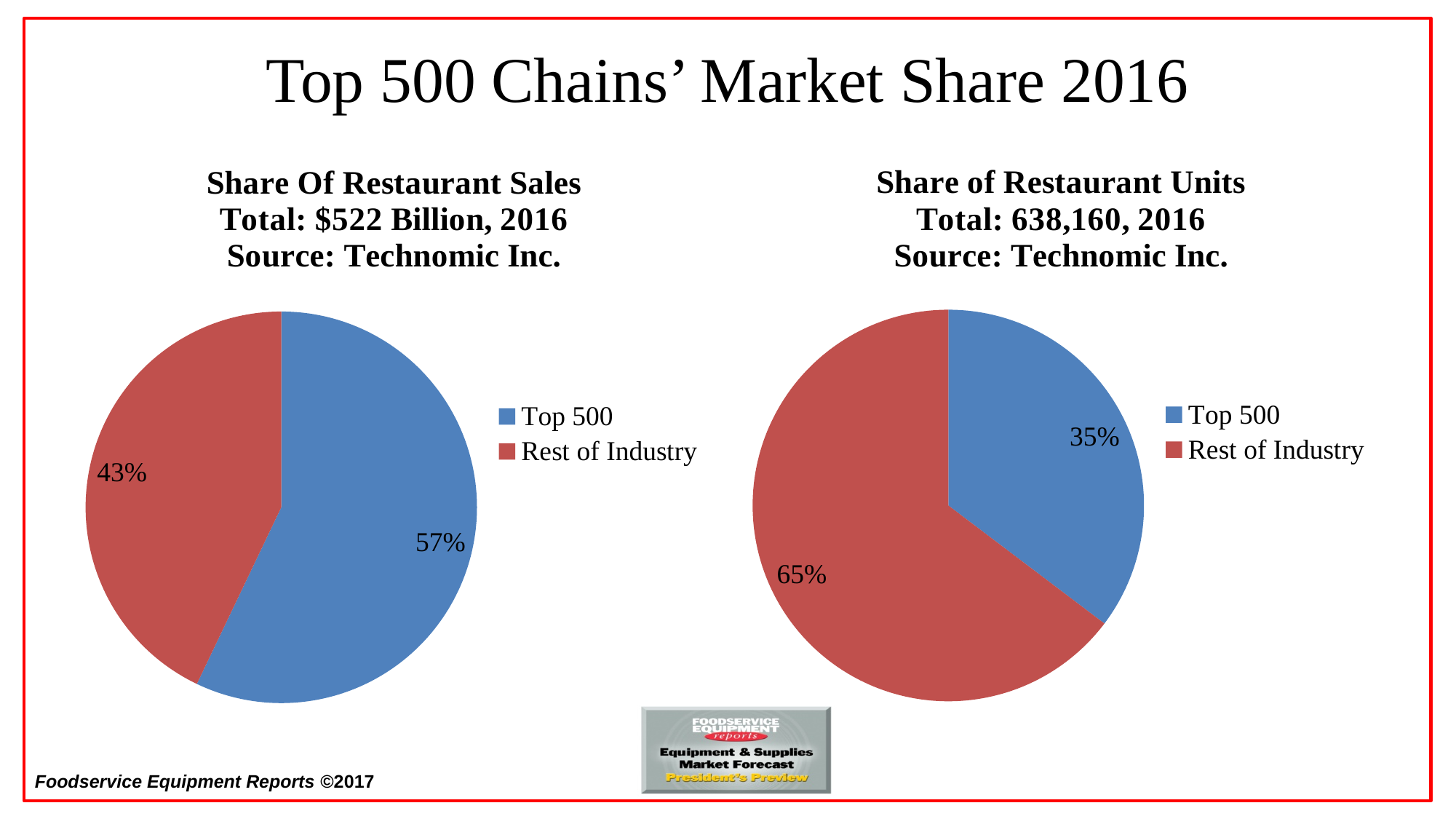
In the Share of Restaurant Units chart, what share do the Top 500 hold? 35% In the Share Of Restaurant Sales chart, what share does the Rest of Industry hold? 43% In the Share of Restaurant Units chart, which slice is the smallest? Top 500 How many series does the legend of the Share of Restaurant Units chart list? 2 What type of chart is used for the Share Of Restaurant Sales chart? Pie chart In the Share of Restaurant Units chart, what is the difference between the Rest of Industry share and the Top 500 share? 30% In the Share Of Restaurant Sales chart, what is the difference between the Top 500 share and the Rest of Industry share? 14% In the Share Of Restaurant Sales chart, which slice is the largest? Top 500 What total is stated in the title of the Share of Restaurant Units chart? 638,160 In the Share of Restaurant Units chart, what share does the Rest of Industry hold? 65% In the Share Of Restaurant Sales chart, what share do the Top 500 hold? 57% Is the Top 500 share larger in the Share Of Restaurant Sales chart or in the Share of Restaurant Units chart? Share Of Restaurant Sales